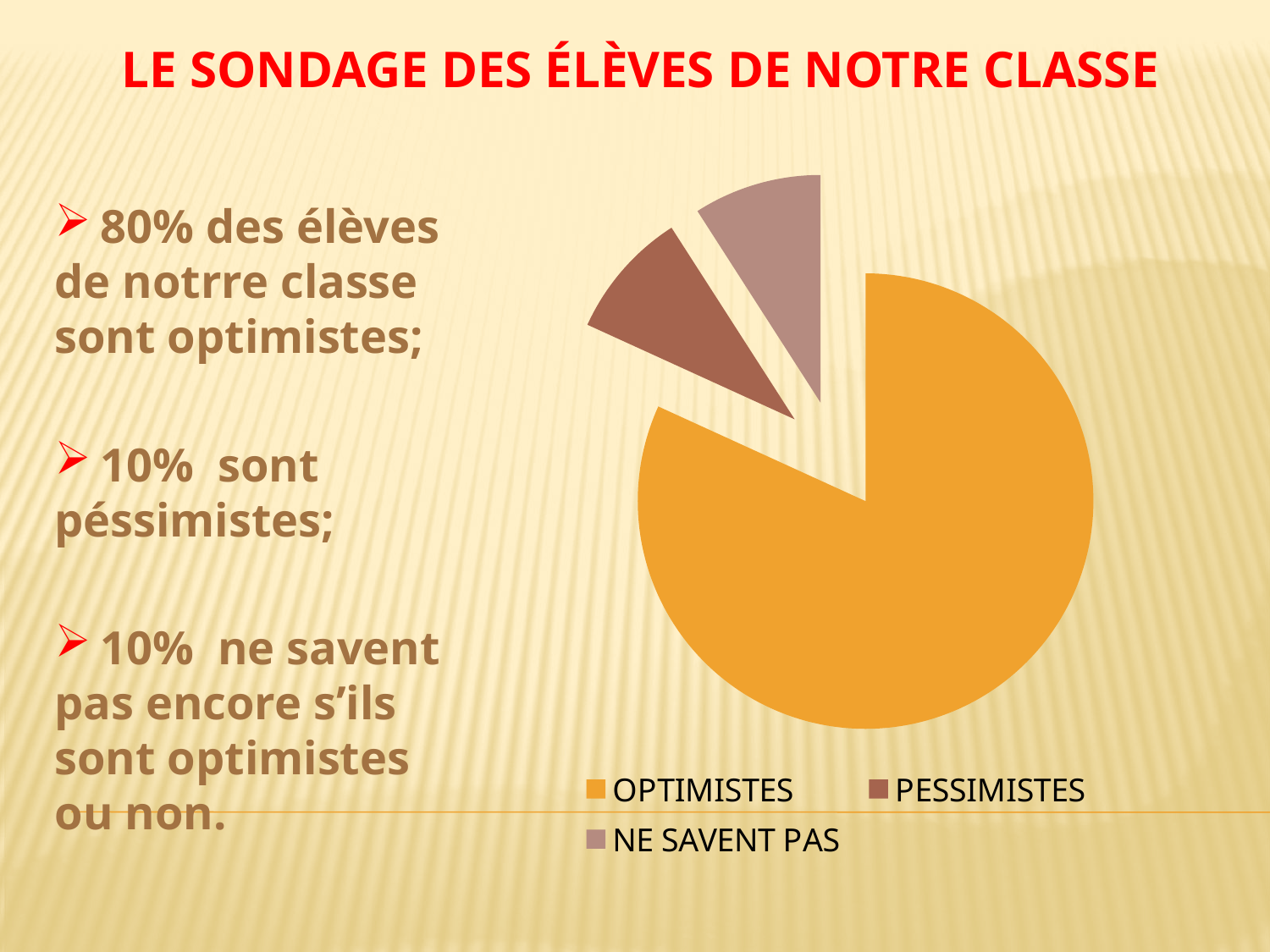
What is the title of the slide containing the pie chart? LE SONDAGE DES ÉLÈVES DE NOTRE CLASSE Which is larger in the pie chart, OPTIMISTES or NE SAVENT PAS? OPTIMISTES What kind of chart is shown on the slide? pie chart Which is larger in the pie chart, OPTIMISTES or PESSIMISTES? OPTIMISTES Which category has the largest slice of the pie chart? OPTIMISTES Which legend entry is shown in orange? OPTIMISTES How many slices does the pie chart have? 3 How many entries does the legend of the pie chart list? 3